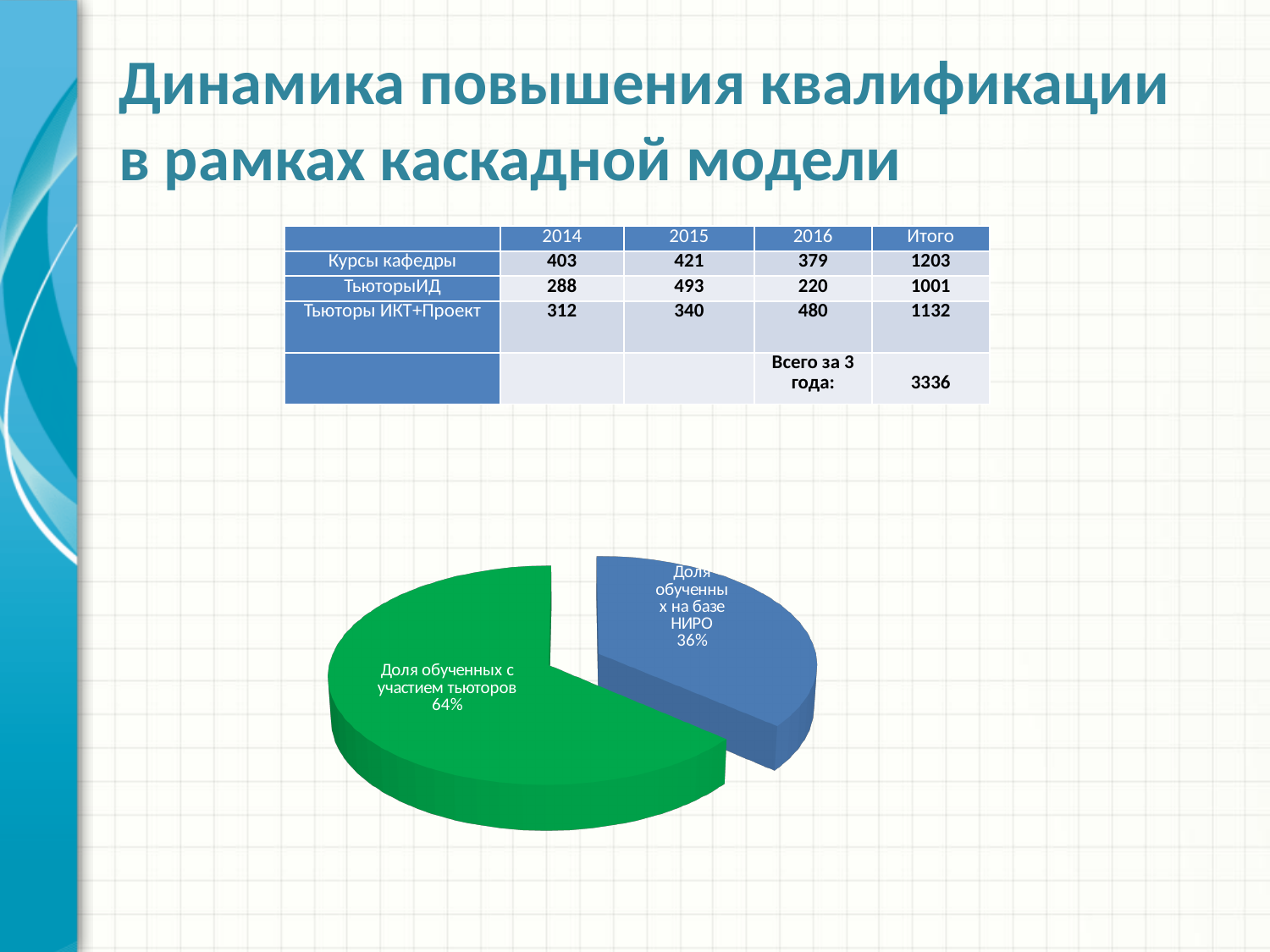
What colour is the "Доля обученных на базе НИРО" slice in the pie chart? blue Is the share for "Доля обученных на базе НИРО" greater or less than 50%? less What kind of chart is shown on the slide? pie chart By how many percentage points does the "Доля обученных с участием тьюторов" slice exceed the "Доля обученных на базе НИРО" slice? 28 Which is larger in the pie chart: the share trained with tutors (с участием тьюторов) or the share trained at НИРО (на базе НИРО)? Доля обученных с участием тьюторов Which slice of the pie chart is the smallest? Доля обученных на базе НИРО What share of the pie is labelled "Доля обученных с участием тьюторов"? 64% How many slices does the pie chart have? 2 Which slice of the pie chart is the largest? Доля обученных с участием тьюторов What share of the pie is labelled "Доля обученных на базе НИРО"? 36% What colour is the "Доля обученных с участием тьюторов" slice in the pie chart? green